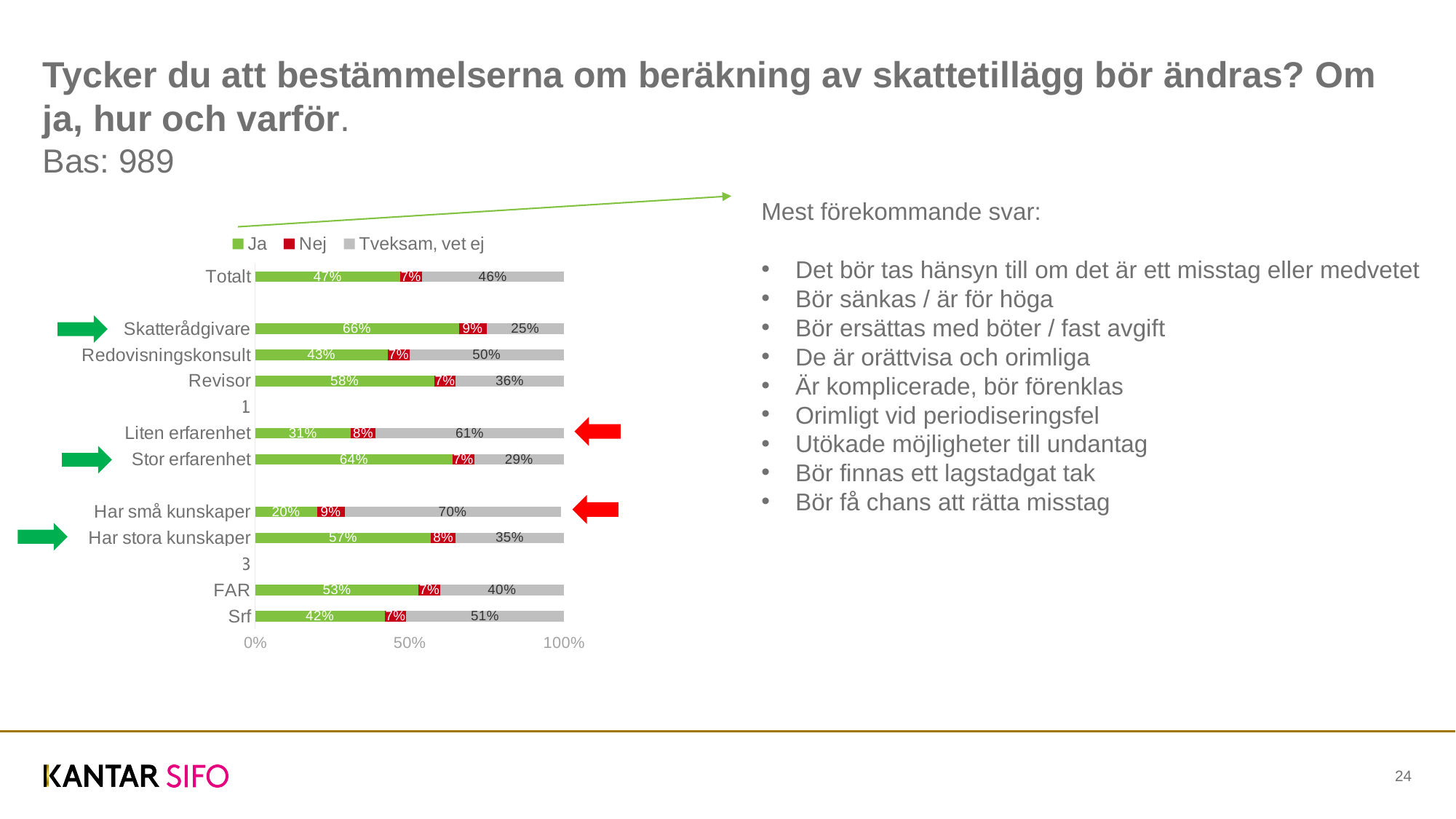
What percentage of the Totalt group answered Nej? 7% What kind of chart is shown on the slide? Stacked bar chart What percentage of Skatterådgivare answered Ja? 66% Which category has the highest Ja share? Skatterådgivare Which series is shown in green in the legend? Ja What is the total of the stacked bar for FAR? 100% Which has a larger Tveksam, vet ej share, Redovisningskonsult or Revisor? Redovisningskonsult What is the Tveksam, vet ej share for Har små kunskaper? 70% What is the Ja value for Srf? 42% What is the difference between the Ja share for Stor erfarenhet and the Ja share for Liten erfarenhet? 33 percentage points Which category has the lowest Ja share? Har små kunskaper How many series does the legend list? 3